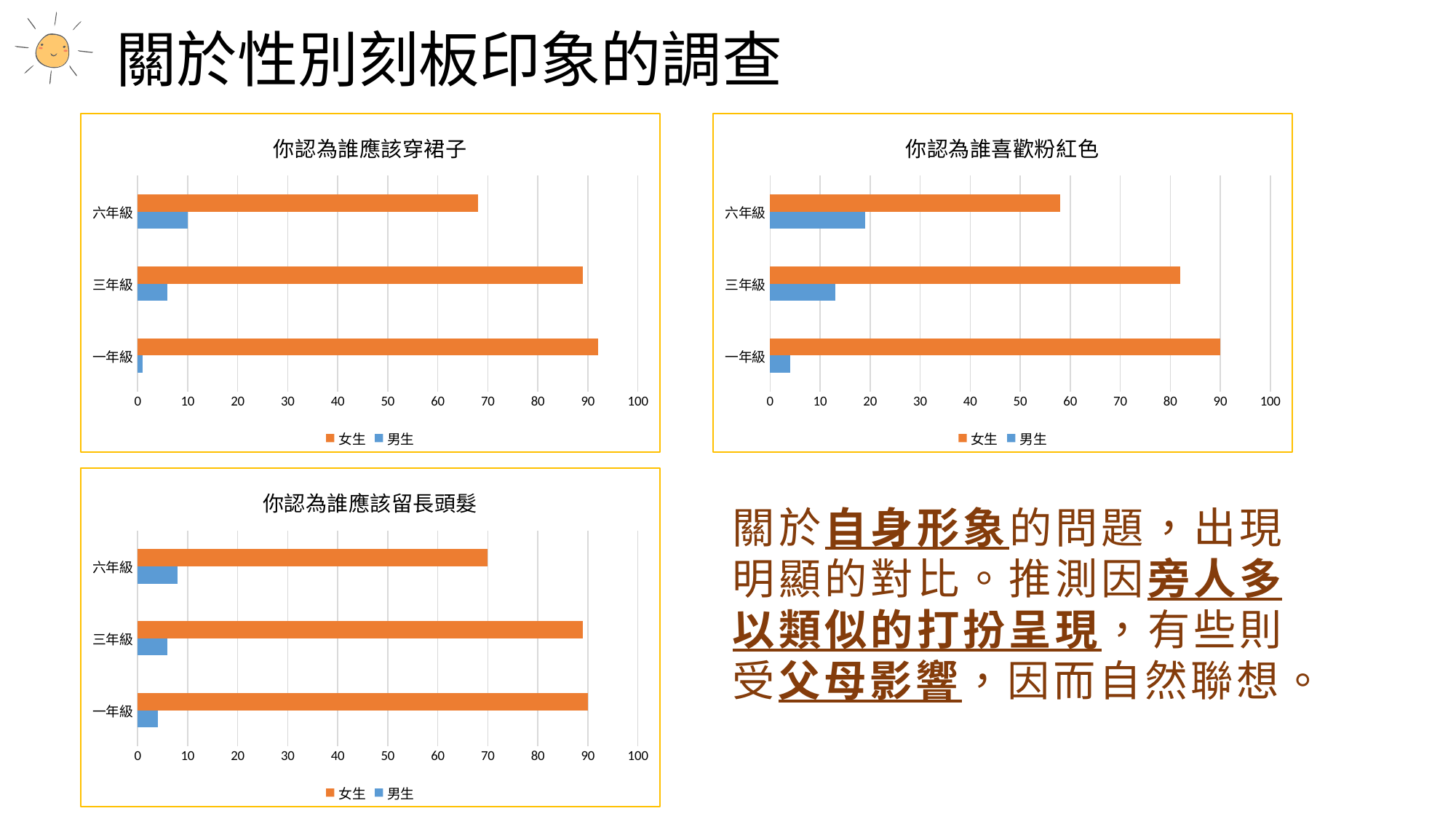
In the chart titled 你認為誰應該留長頭髮, is the 男生 value for 一年級 greater or less than 10? less In the chart titled 你認為誰應該留長頭髮, which is larger for 六年級: the 女生 value or the 男生 value? 女生 What kind of chart is the chart titled 你認為誰應該穿裙子? bar chart How many series does the legend list in the chart titled 你認為誰喜歡粉紅色? 2 In the chart titled 你認為誰喜歡粉紅色, which grade has the highest 女生 value? 一年級 In the chart titled 你認為誰喜歡粉紅色, is the 女生 value for 三年級 greater or less than 70? greater In the chart titled 你認為誰應該穿裙子, which grade has the lowest 女生 value? 六年級 Which colour represents the 男生 series in the chart titled 你認為誰應該留長頭髮? blue How many grade categories are shown in the chart titled 你認為誰應該留長頭髮? 3 In the chart titled 你認為誰應該穿裙子, is the 女生 value for 六年級 greater or less than 60? greater In the chart titled 你認為誰應該穿裙子, which grade has the highest 男生 value? 六年級